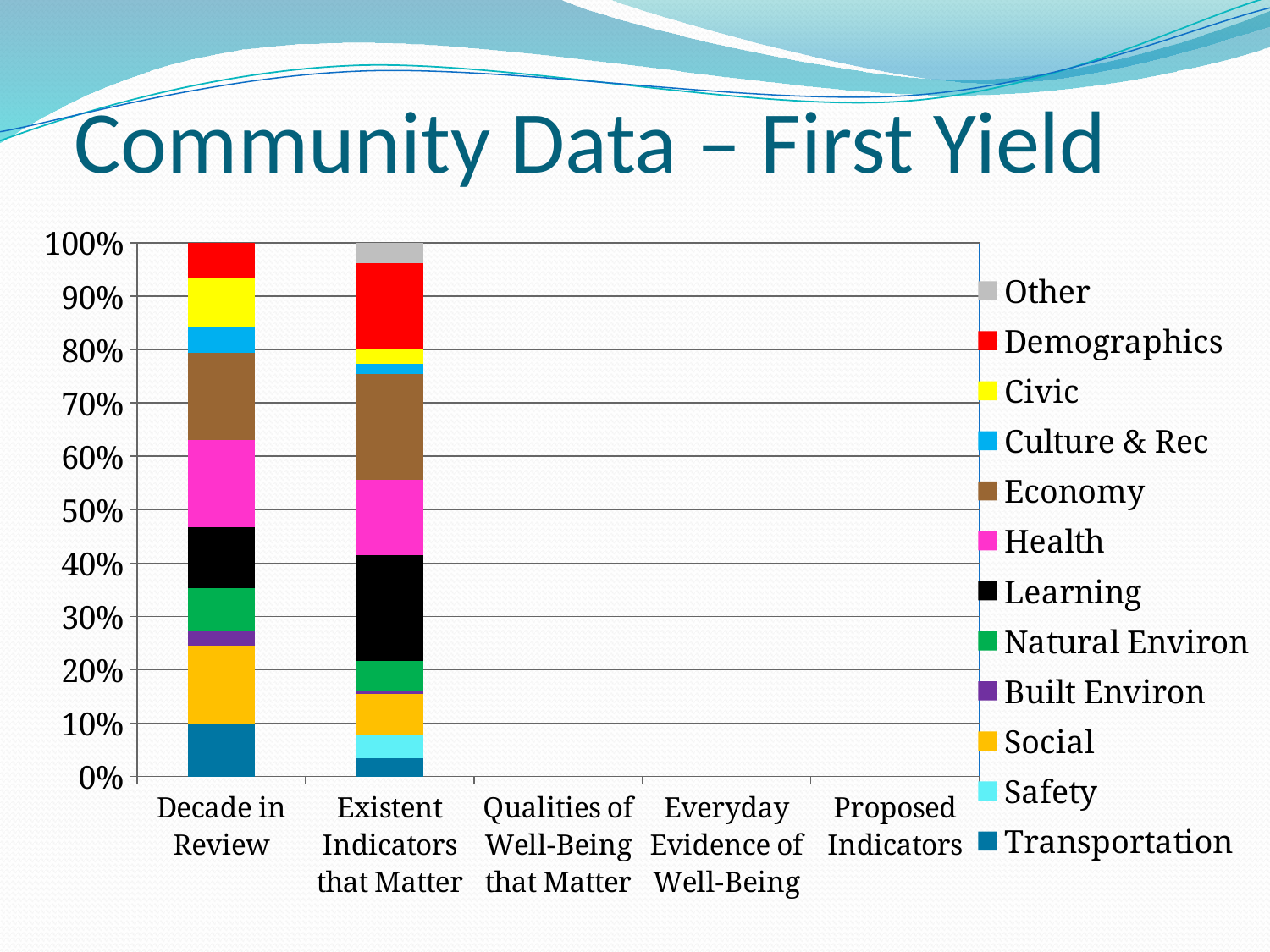
Is the Transportation share in the Existent Indicators that Matter bar greater or less than 10%? less How many series does the legend list? 12 Is the Social segment larger in the Decade in Review bar or the Existent Indicators that Matter bar? Decade in Review Is the Transportation segment larger in the Decade in Review bar or the Existent Indicators that Matter bar? Decade in Review How many categories are labelled along the x axis? 5 How many of the x-axis categories have a plotted bar? 2 Which series is shown in red in the legend? Demographics What kind of chart is shown on the slide? Stacked bar chart What is the title of the slide containing the chart? Community Data – First Yield Is the Civic segment larger in the Decade in Review bar or the Existent Indicators that Matter bar? Decade in Review